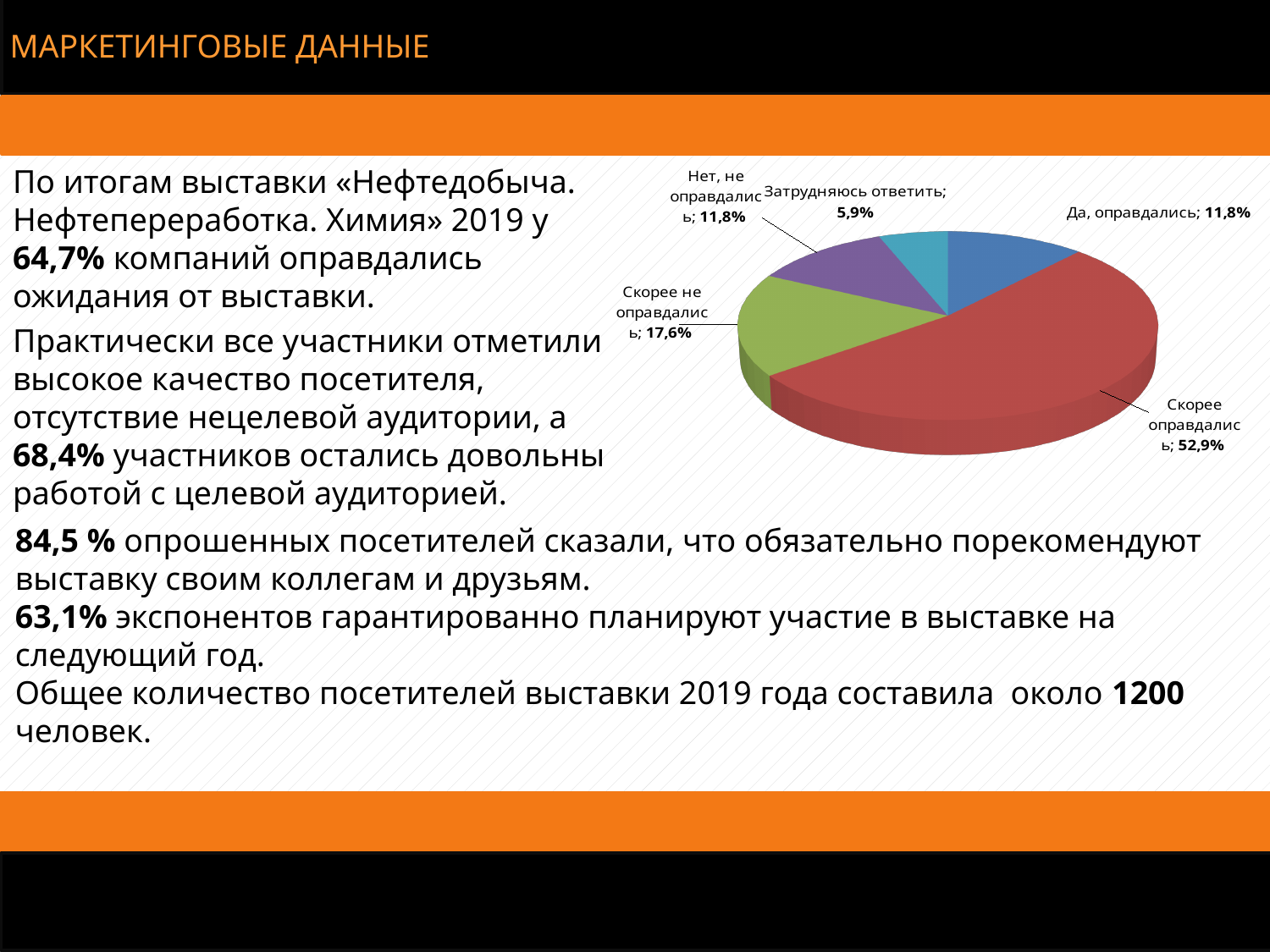
What share of the pie is labelled "Скорее оправдались"? 52,9% Which category has the largest slice of the pie? Скорее оправдались What kind of chart is shown on the slide? Pie chart What is the value shown for "Да, оправдались"? 11,8% What is the value shown for "Скорее не оправдались"? 17,6% What is the combined share of "Да, оправдались" and "Скорее оправдались"? 64,7% Which is larger: "Скорее не оправдались" or "Нет, не оправдались"? Скорее не оправдались Which category has the smallest slice of the pie? Затрудняюсь ответить What is the value shown for "Затрудняюсь ответить"? 5,9% What is the difference between the shares for "Скорее оправдались" and "Скорее не оправдались"? 35,3% What colour is the "Скорее оправдались" slice? Red How many slices does the pie chart have? 5